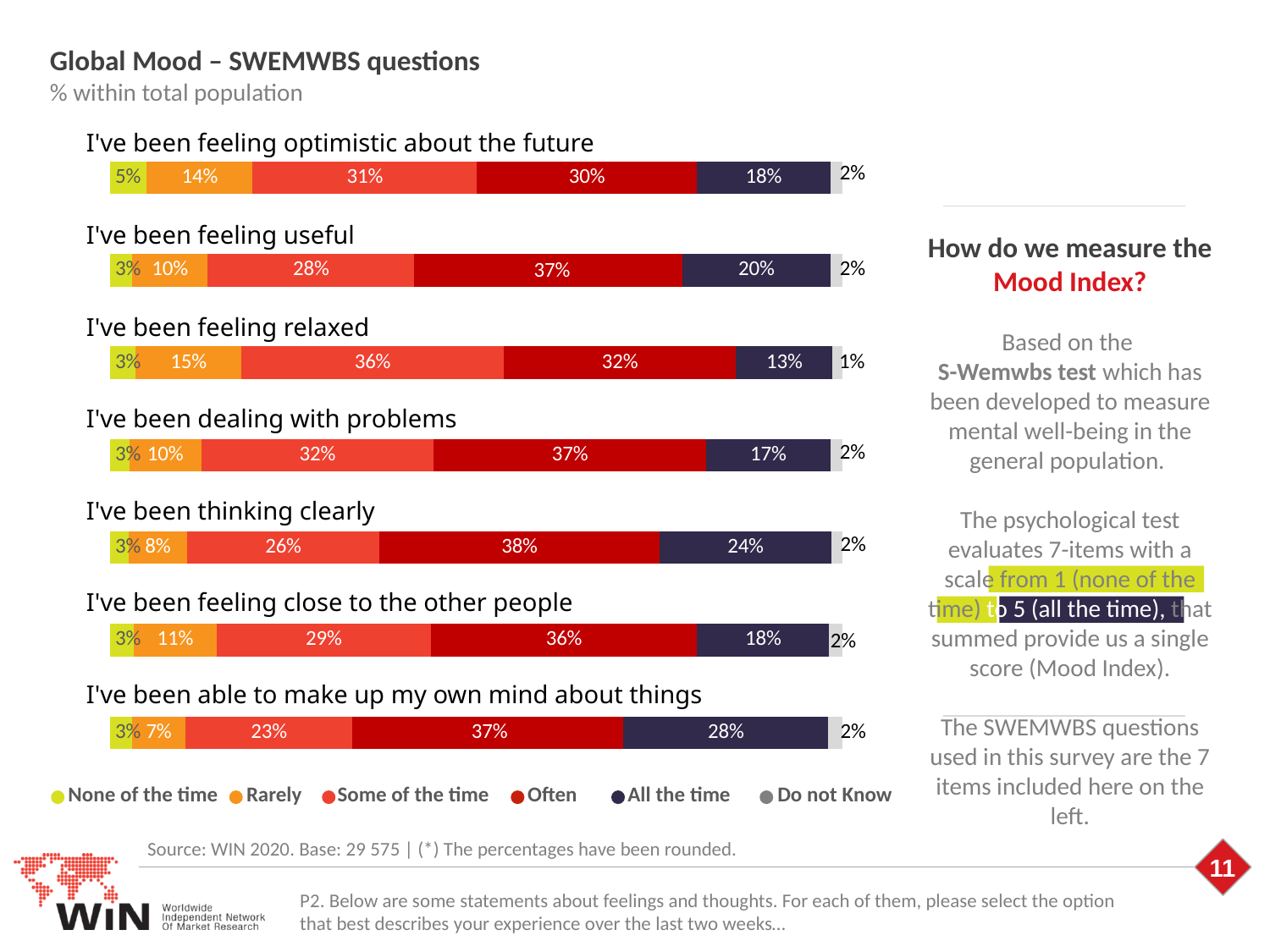
Which legend entry is shown in the darkest (navy) colour? All the time How many SWEMWBS statements are charted on the slide? 7 In the chart 'I've been feeling optimistic about the future', what is the combined percentage of 'Often' and 'All the time'? 48% In the chart 'I've been feeling relaxed', what percentage answered 'All the time'? 13% In the chart 'I've been feeling optimistic about the future', what percentage answered 'Some of the time'? 31% In the chart 'I've been feeling close to the other people', what is the difference between the 'Often' and 'Some of the time' percentages? 7% In the chart 'I've been dealing with problems', which is larger: 'Some of the time' or 'All the time'? Some of the time What kind of chart is used for each statement on the slide? Stacked bar chart In the chart 'I've been able to make up my own mind about things', which response category has the lowest percentage? Do not Know In the chart 'I've been feeling useful', what percentage answered 'Often'? 37% In the chart 'I've been thinking clearly', which response category has the highest percentage? Often How many response categories does the legend list? 6